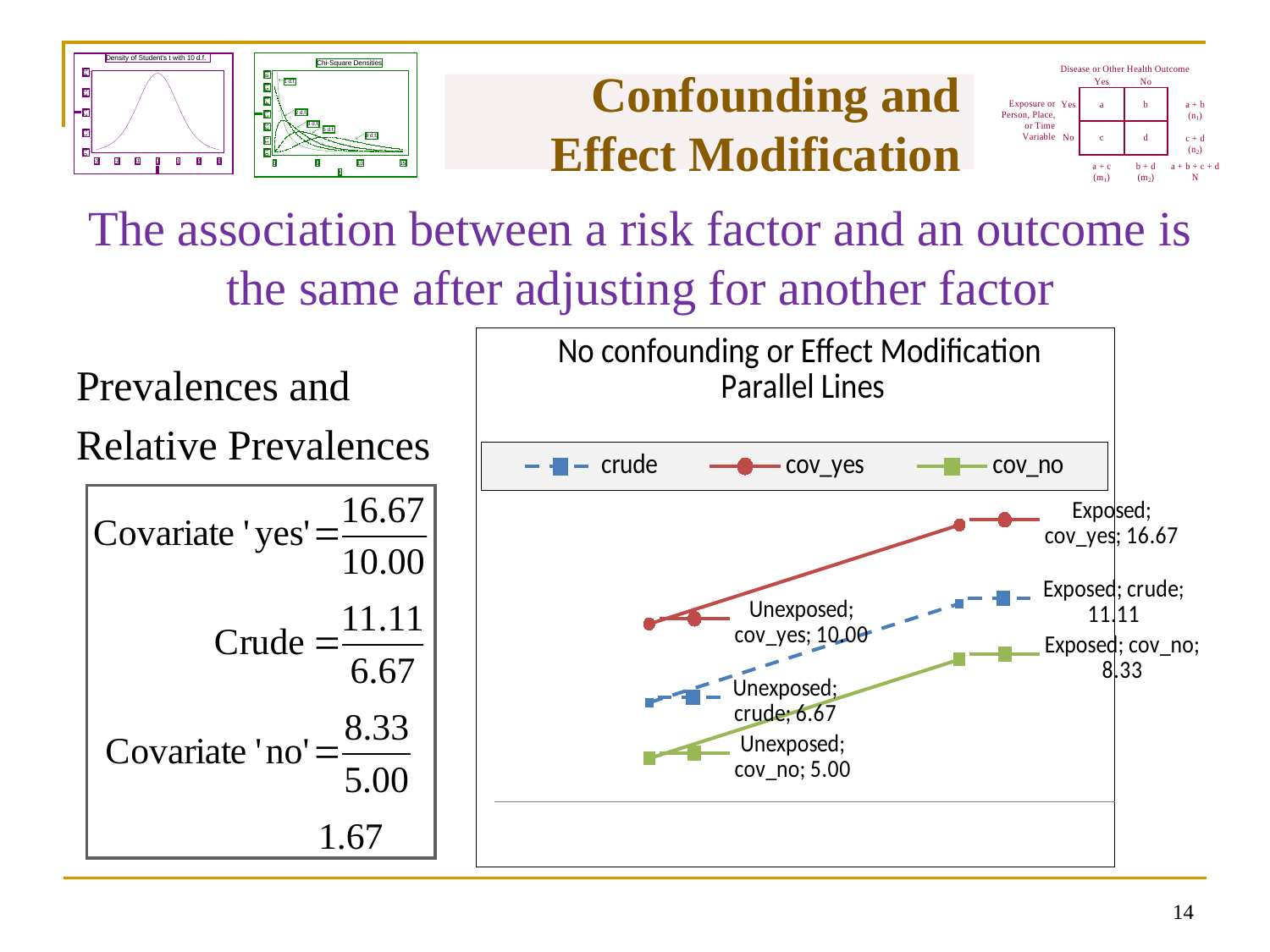
Do the values rise or fall from Unexposed to Exposed in the cov_no series? rise What is the value for Exposed in the cov_no series? 8.33 Which series has the lowest value for Unexposed? cov_no What is the value for Exposed in the cov_yes series? 16.67 Which series has the highest value for Exposed? cov_yes How many series does the chart legend list? 3 What is the difference between the Exposed and Unexposed values in the crude series? 4.44 What is the value for Unexposed in the cov_yes series? 10.00 What kind of chart is shown on the slide? line chart What is the title of the chart on the slide? No confounding or Effect Modification Parallel Lines What is the value for Unexposed in the crude series? 6.67 Which is larger: the Exposed value for cov_no or the Unexposed value for cov_yes? Unexposed value for cov_yes